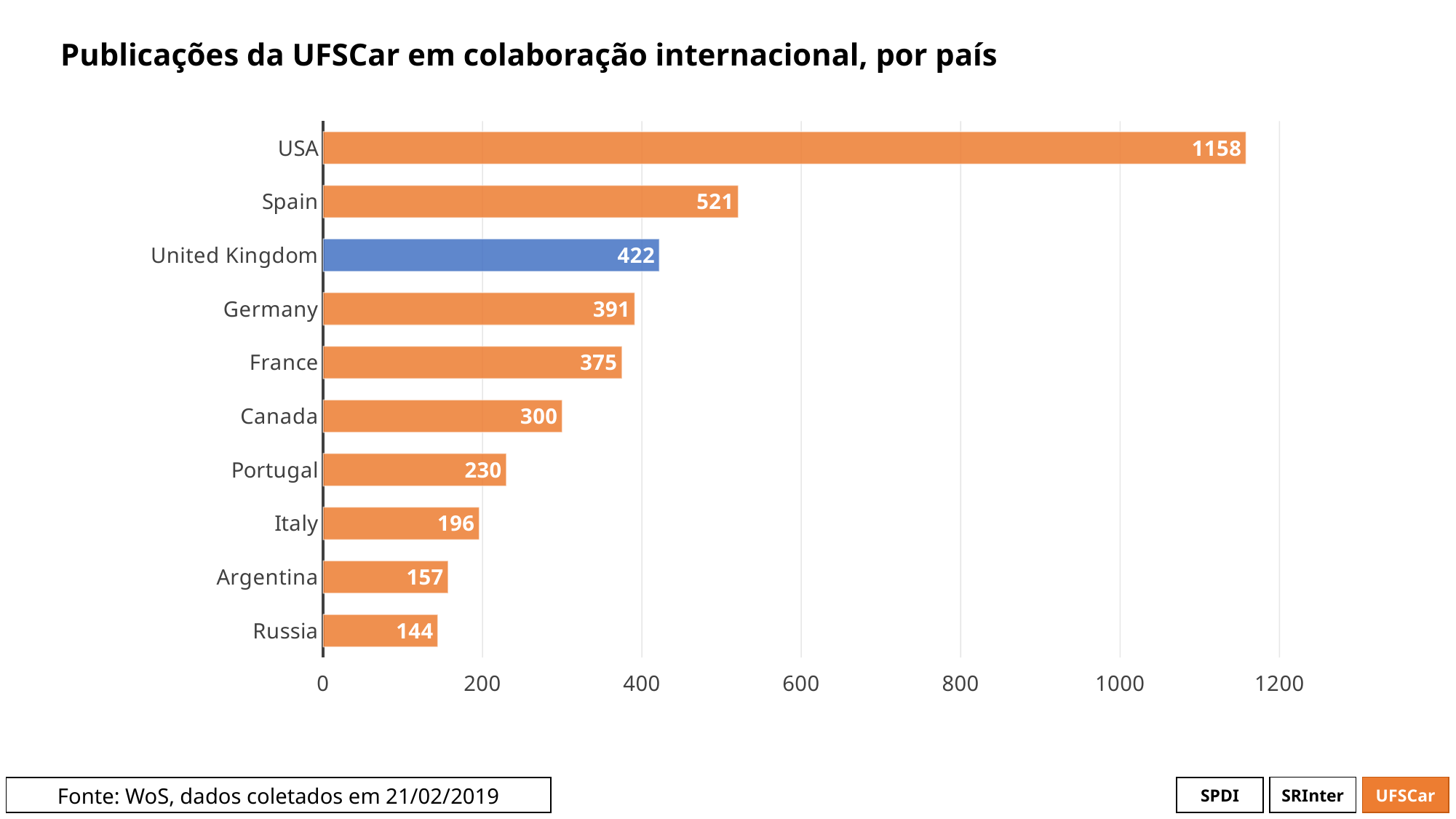
Which country's bar is coloured blue instead of orange? United Kingdom Is the value for Spain greater or less than 400? greater What is the value for Germany? 391 How many countries are shown in the chart? 10 What is the difference between the values for Canada and Italy? 104 What is the difference between the values for Spain and United Kingdom? 99 Which is larger, the value for France or the value for Argentina? France What is the value for Portugal? 230 What kind of chart is shown on the slide? bar chart Which country has the lowest value? Russia What is the value for USA? 1158 Which country has the highest value? USA